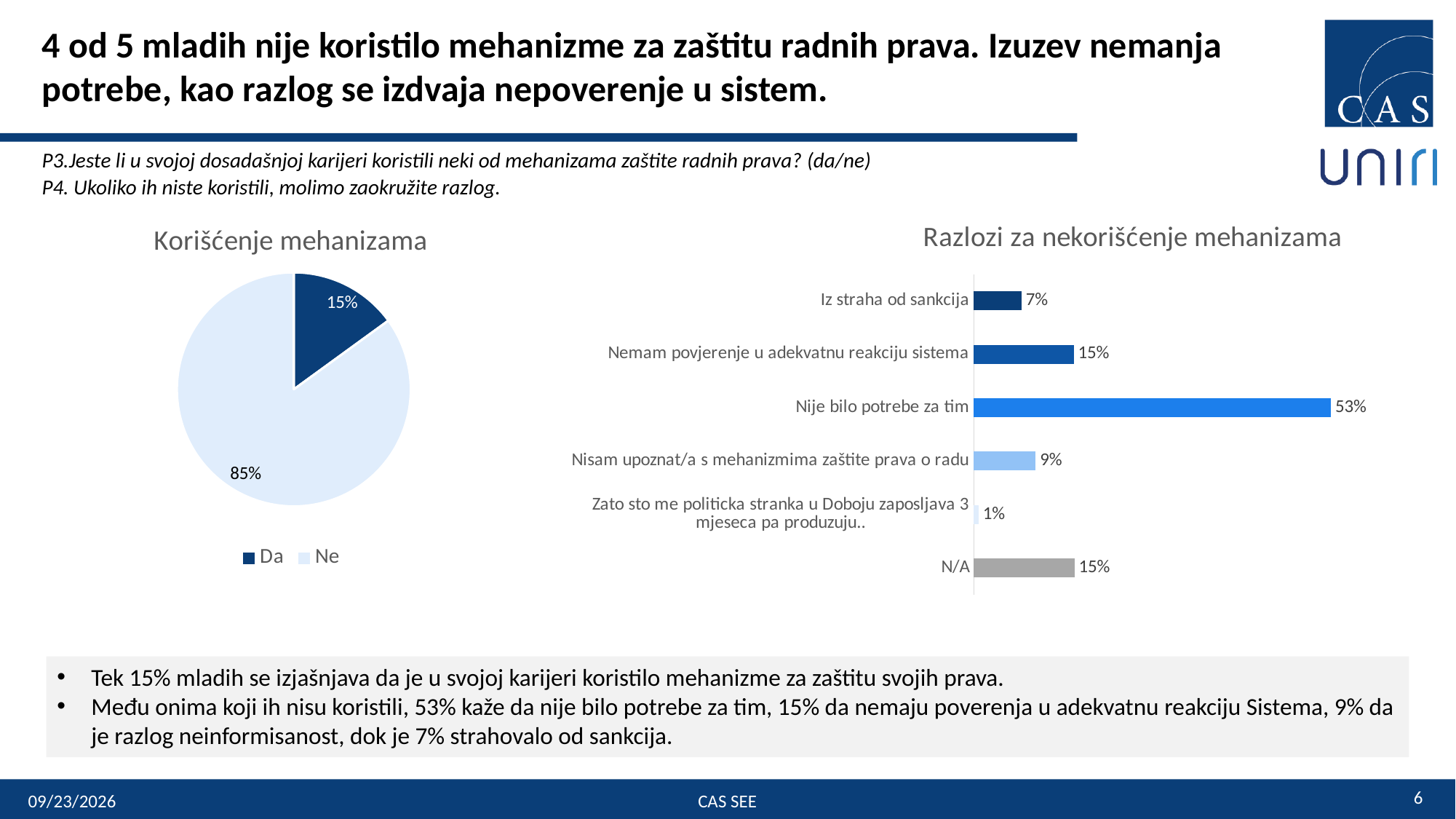
In the 'Korišćenje mehanizama' chart, what share of respondents answered 'Ne'? 85% In the 'Korišćenje mehanizama' chart, what share of respondents answered 'Da'? 15% In the 'Razlozi za nekorišćenje mehanizama' chart, what is the difference between 'Nije bilo potrebe za tim' and 'Nemam povjerenje u adekvatnu reakciju sistema'? 38% How many entries does the legend of the 'Korišćenje mehanizama' chart list? 2 In the 'Razlozi za nekorišćenje mehanizama' chart, what is the value for 'Nisam upoznat/a s mehanizmima zaštite prava o radu'? 9% In the 'Razlozi za nekorišćenje mehanizama' chart, what is the value for 'Iz straha od sankcija'? 7% In the 'Razlozi za nekorišćenje mehanizama' chart, which category has the lowest value? Zato sto me politicka stranka u Doboju zaposljava 3 mjeseca pa produzuju.. In the 'Razlozi za nekorišćenje mehanizama' chart, what is the value for 'Nije bilo potrebe za tim'? 53% How many categories are shown in the 'Razlozi za nekorišćenje mehanizama' chart? 6 In the 'Razlozi za nekorišćenje mehanizama' chart, which is larger: 'Iz straha od sankcija' or 'Nisam upoznat/a s mehanizmima zaštite prava o radu'? Nisam upoznat/a s mehanizmima zaštite prava o radu In the 'Razlozi za nekorišćenje mehanizama' chart, which category has the highest value? Nije bilo potrebe za tim What kind of chart is 'Korišćenje mehanizama'? Pie chart